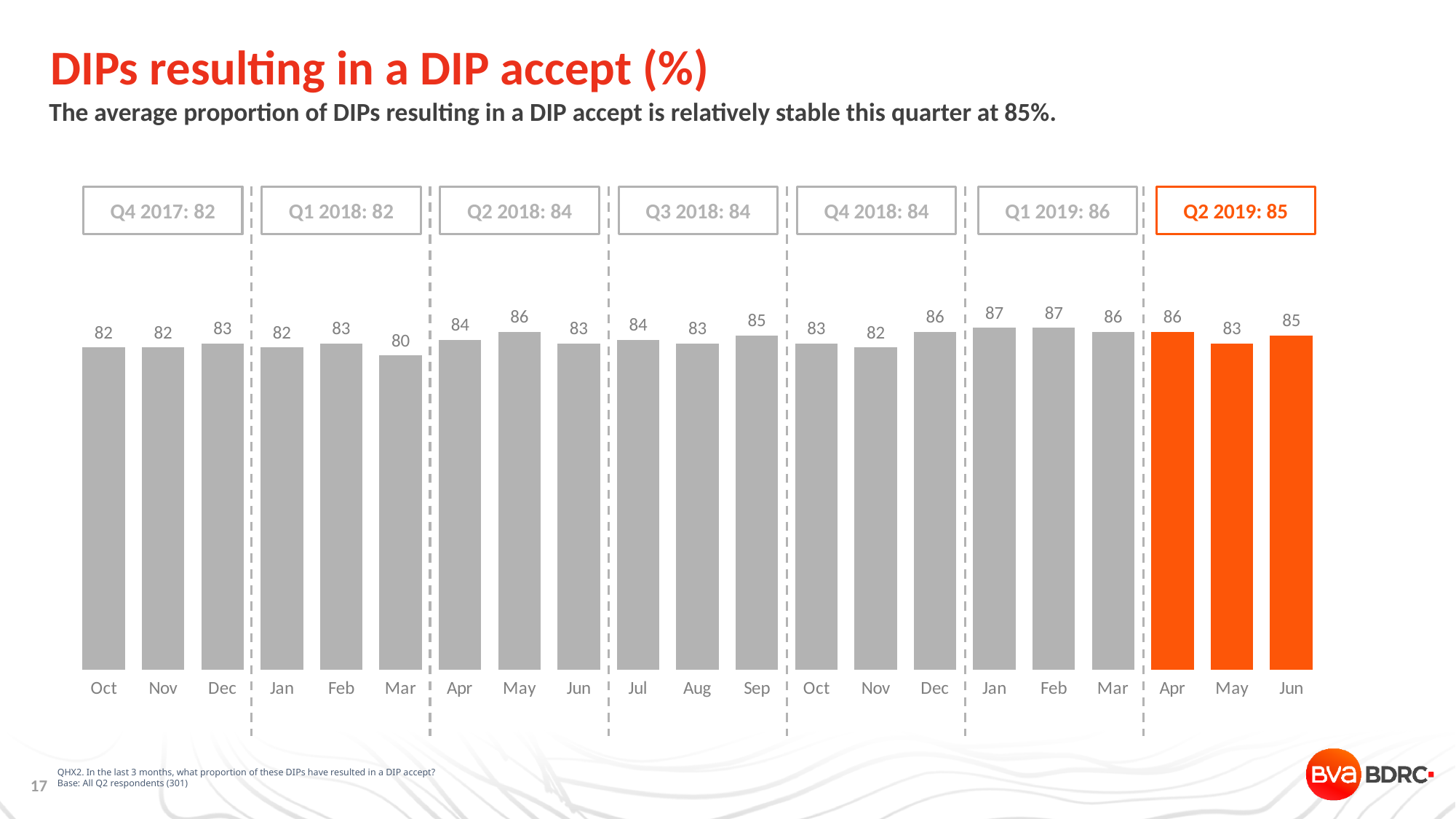
Which month has the lowest value on the chart? Mar (Q1 2018) What colour are the bars for Q2 2019? Orange What is the highest monthly value shown on the chart? 87 What is the value for Mar in Q1 2018? 80 What is the value for Sep in Q3 2018? 85 Which is larger, the value for May in Q2 2018 or the value for May in Q2 2019? May in Q2 2018 Across the three months of Q1 2019 (Jan to Mar), do the values rise or fall? Fall What quarterly average is shown in the box for Q1 2019? 86 What kind of chart is shown on the slide? Bar chart How many monthly bars are plotted on the chart? 21 What is the difference between the value for Jan in Q1 2019 and the value for Mar in Q1 2018? 7 What is the value for Jun in Q2 2019? 85